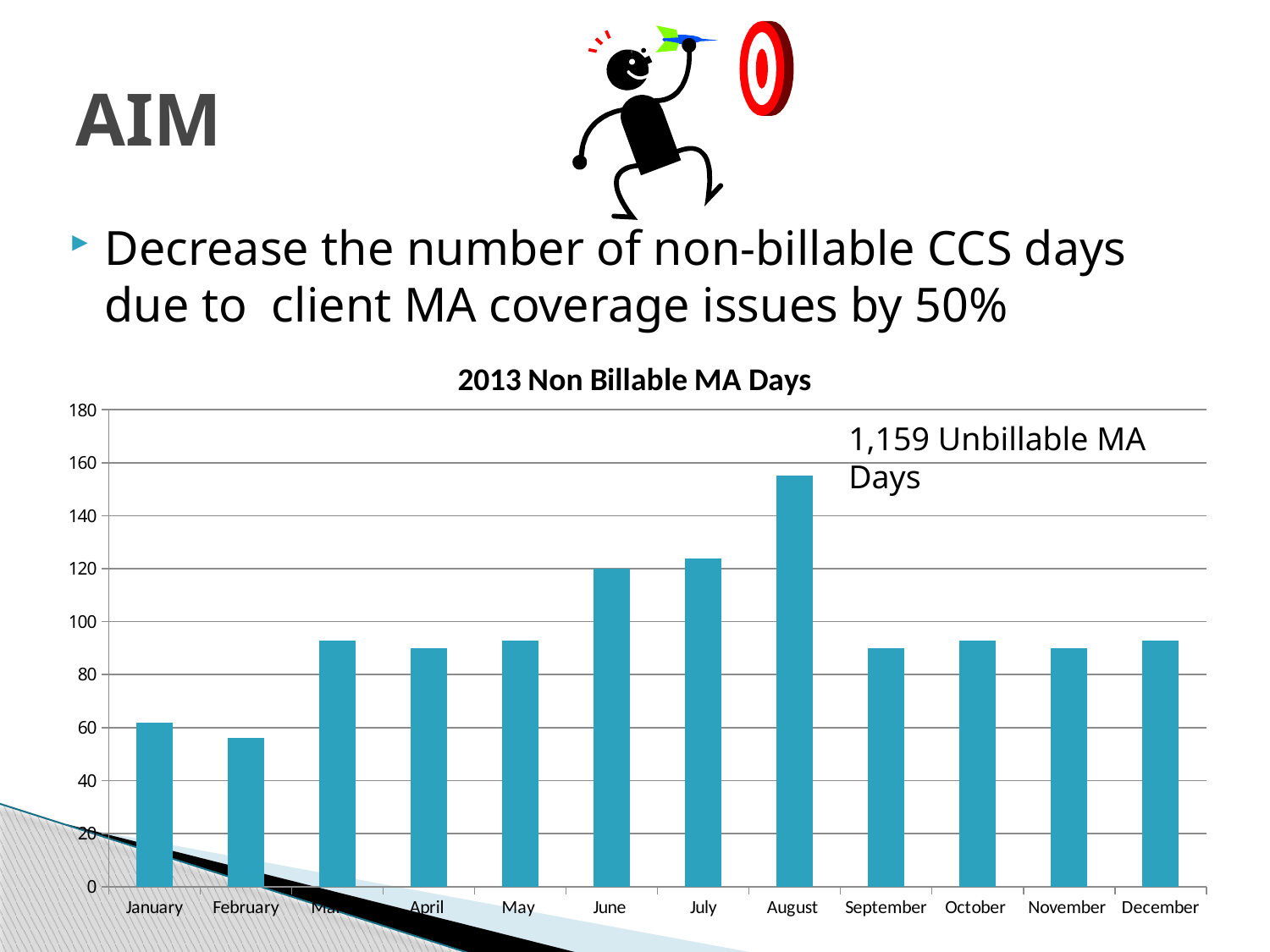
What is the title of the chart? 2013 Non Billable MA Days Is the value for January greater or less than 80? less What kind of chart is shown on the slide? bar chart Which is larger, the value for January or the value for February? January Which month has the highest number of non billable MA days? August Which is larger, the value for June or the value for September? June Is the value for February greater or less than 60? less Is the value for August greater or less than 140? greater Do the values rise or fall from June to August? rise How many months are plotted on the chart? 12 Which month has the lowest number of non billable MA days? February